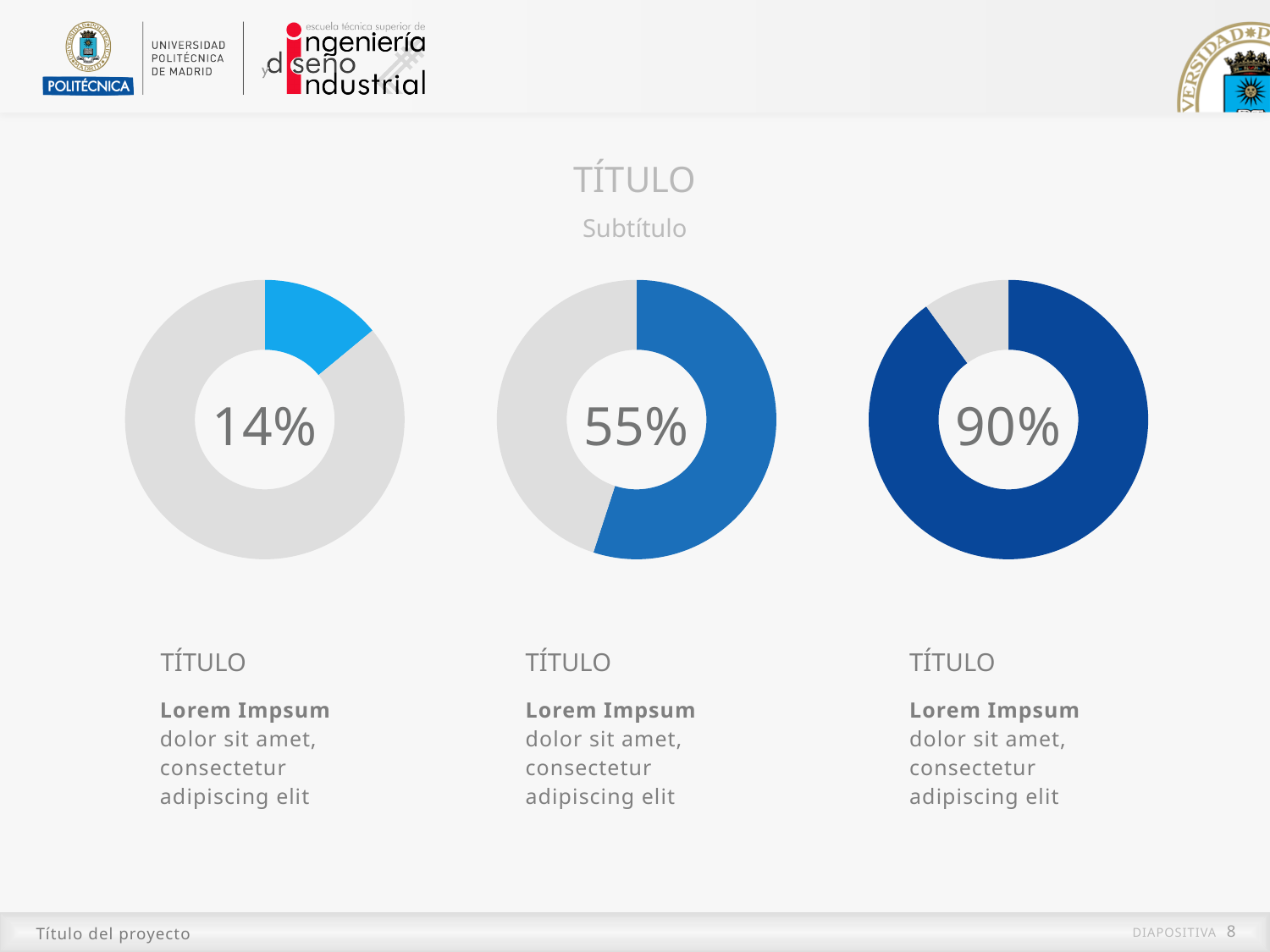
What percentage is shown in the centre of the left donut chart? 14% Which of the three donut charts shows the lowest percentage? The left chart (14%) Is the value shown in the middle donut chart greater or less than 50%? greater What is the difference between the percentage in the right donut chart and the percentage in the left donut chart? 76% What percentage is shown in the centre of the right donut chart? 90% What is the difference between the percentage in the middle donut chart and the percentage in the left donut chart? 41% Which is larger, the percentage in the middle donut chart or the percentage in the right donut chart? The right chart (90%) What kind of chart is used for the three figures on the slide? Donut (pie) chart How many donut charts are shown on the slide? 3 Which of the three donut charts shows the highest percentage? The right chart (90%) What percentage is shown in the centre of the middle donut chart? 55% Do the percentages increase or decrease from the left donut chart to the right donut chart? Increase